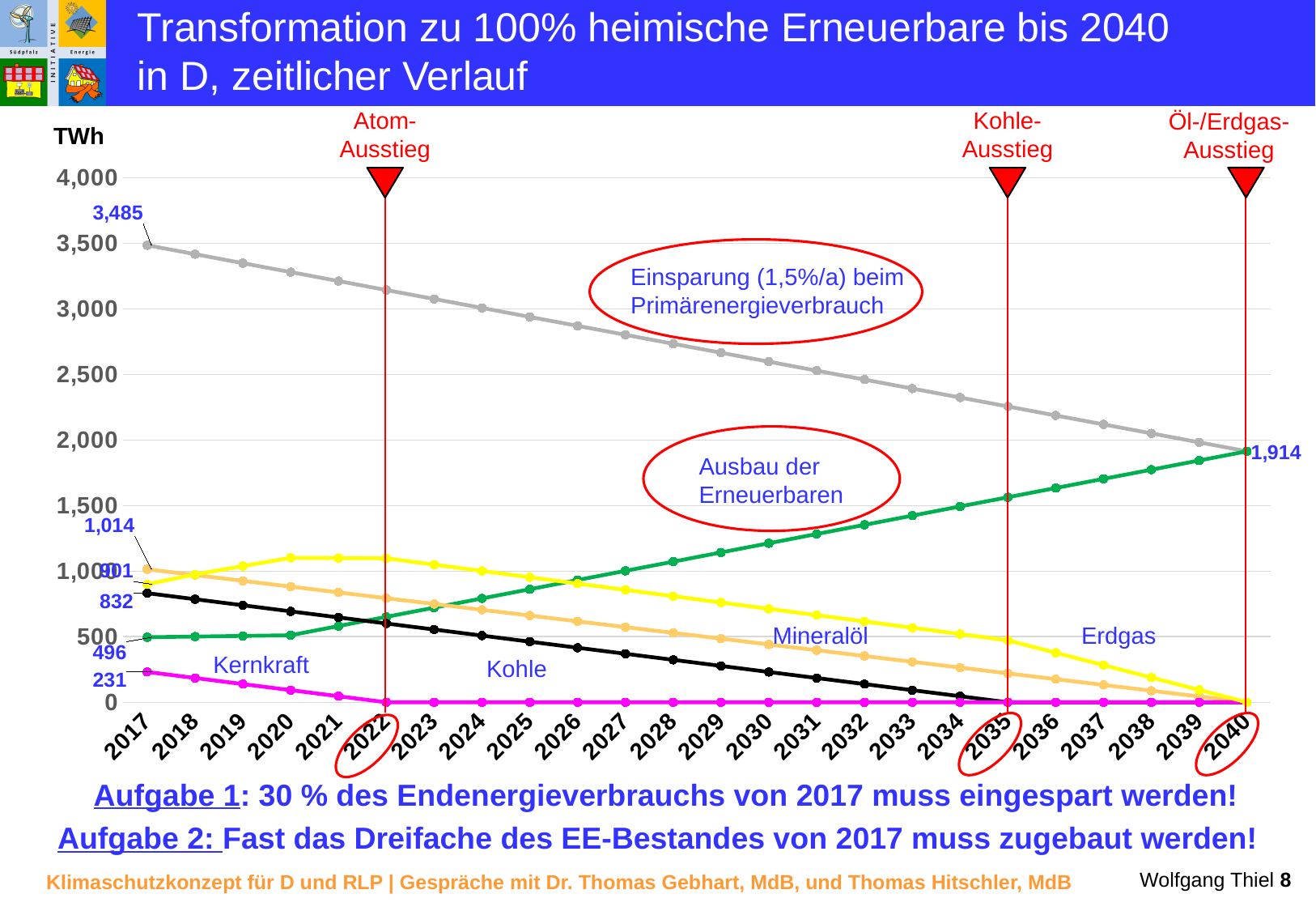
Which is larger in 2017, Mineralöl or Erdgas? Mineralöl What kind of chart is shown on the slide? line chart What is the value for Erdgas in 2017 (TWh)? 901 What is the value for Mineralöl in 2017 (TWh)? 1,014 What value is labelled at 2040 where the green Erneuerbare line ends? 1,914 How many years are shown on the x axis? 24 In which year is the Kohle-Ausstieg marked on the chart? 2035 What is the 2017 value labelled on the grey Primärenergieverbrauch line? 3,485 What is the value for Kohle in 2017 (TWh)? 832 What is the value for Kernkraft in 2017 (TWh)? 231 Is the value for Kohle in 2030 greater or less than 500? less What is the difference between the 2017 values for Mineralöl and Erdgas? 113